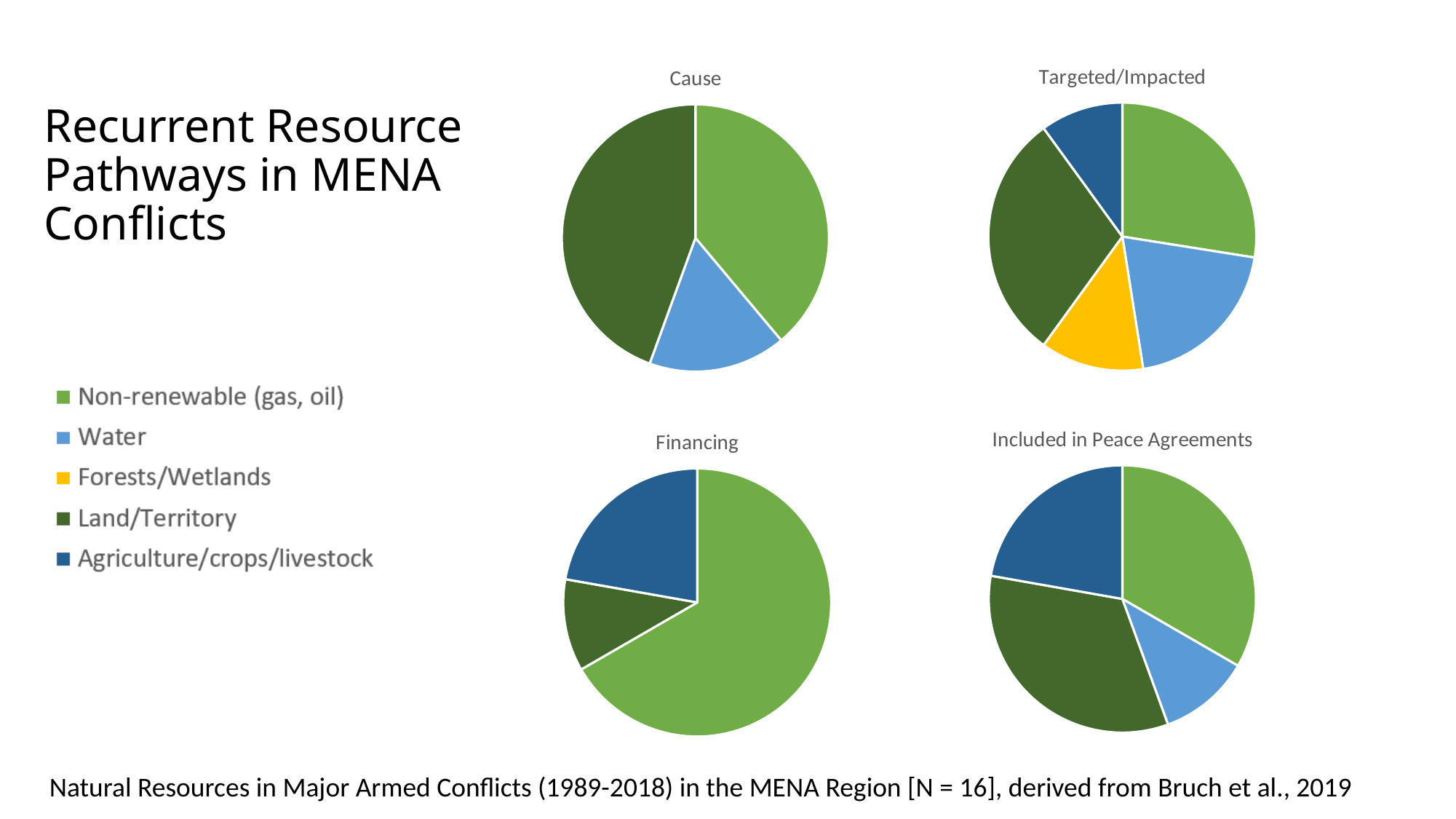
In the Financing pie chart, which category has the smallest slice? Land/Territory In the Financing pie chart, which category has the largest slice? Non-renewable (gas, oil) In the Cause pie chart, which category has the smallest slice? Water In the Targeted/Impacted pie chart, how many slices are there? 5 In the Included in Peace Agreements pie chart, which category has the smallest slice? Water How many series does the legend list? 5 What kind of charts are shown on the slide? Pie charts In the Financing pie chart, how many slices are there? 3 Which of the four pie charts includes a Forests/Wetlands slice? Targeted/Impacted In the Included in Peace Agreements pie chart, how many slices are there? 4 In the Targeted/Impacted pie chart, which slice is larger: Water or Forests/Wetlands? Water